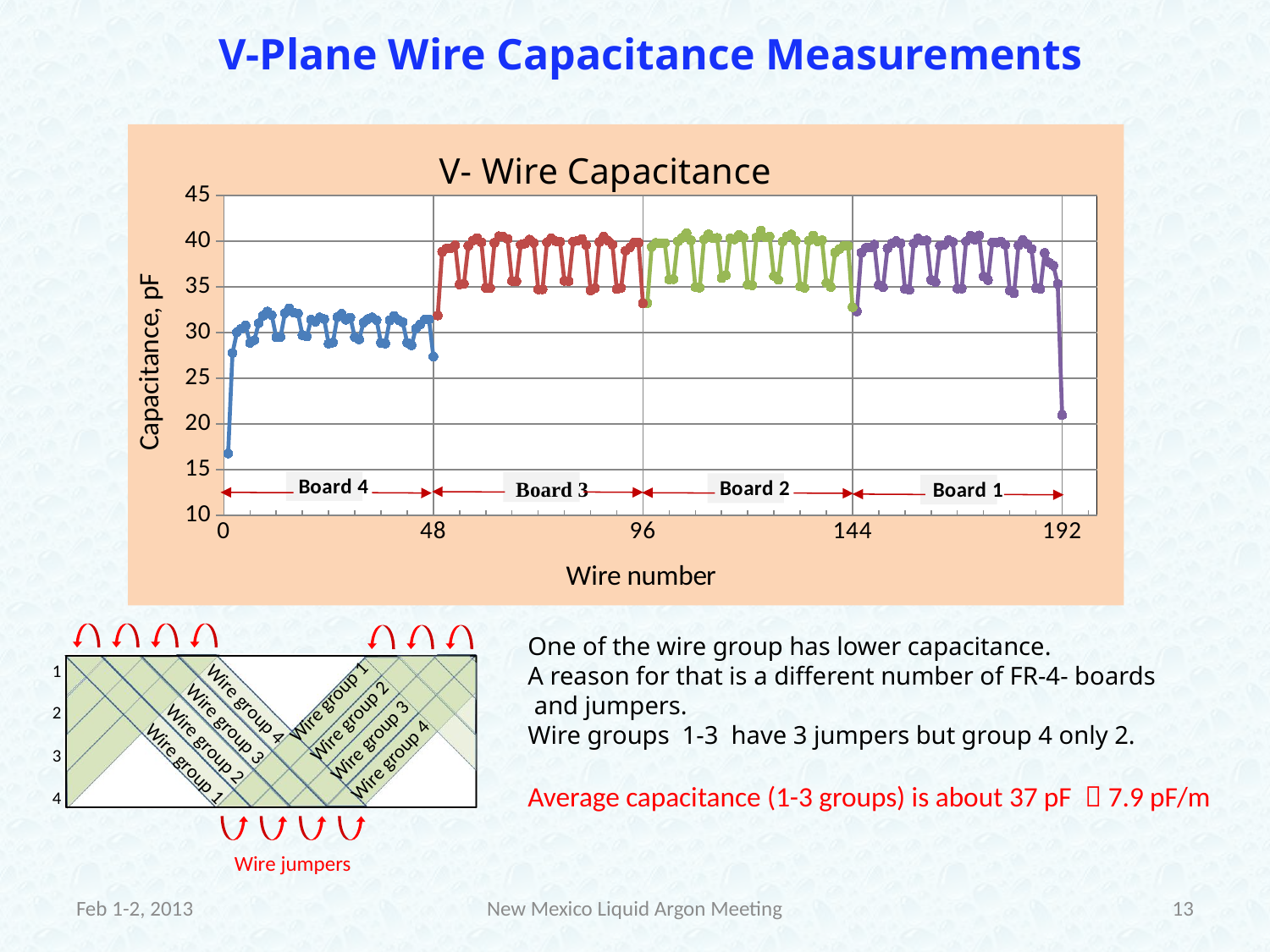
What is the title of the chart? V- Wire Capacitance Is the capacitance for wire number 0 greater or less than 20 pF? less Is the capacitance for wire number 192 greater or less than 25 pF? less What kind of chart is shown on the slide? Line chart with markers What is the largest wire number shown on the x axis of the chart? 192 Which has higher capacitance values, the Board 3 wires or the Board 4 wires? Board 3 Which board has the lowest wire capacitance values in the chart? Board 4 What is the label of the vertical axis of the chart? Capacitance, pF How many boards are labeled along the x axis of the chart? 4 What is the highest value shown on the y axis of the chart? 45 Are the capacitance values for the Board 2 wires greater or less than 30 pF? greater